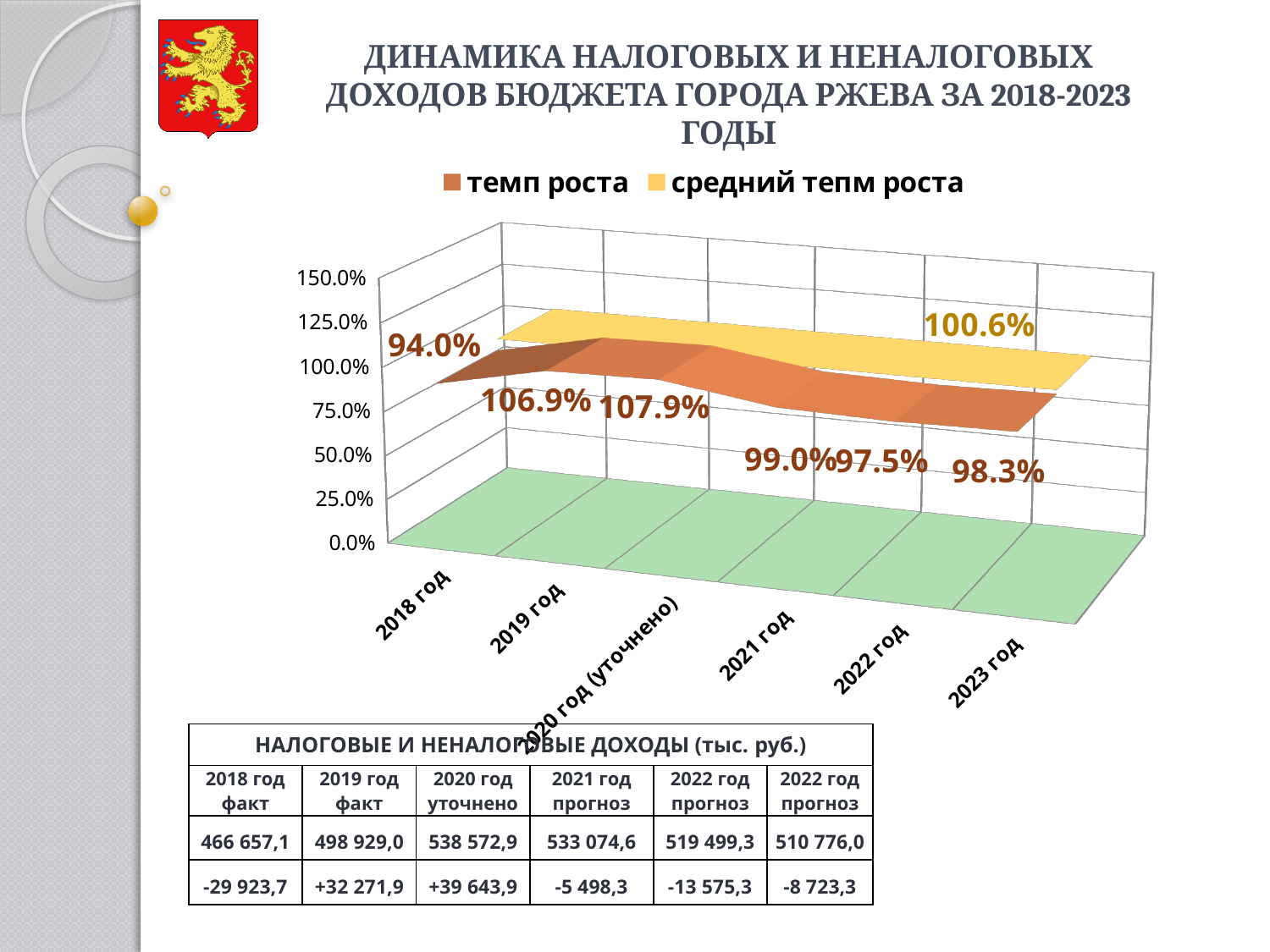
What is the value of темп роста for 2023 год? 98.3% In which year is темп роста lowest? 2018 год What is the value of темп роста for 2018 год? 94.0% What is the difference between темп роста in 2020 год (уточнено) and 2019 год? 1.0% How many series does the chart legend list? 2 What value is labelled for the средний тепм роста series? 100.6% Which is larger, темп роста for 2021 год or for 2022 год? 2021 год In which year is темп роста highest? 2020 год (уточнено) What is the value of темп роста for 2020 год (уточнено)? 107.9% How many years are shown on the x axis of the chart? 6 Does темп роста rise or fall from 2020 год (уточнено) to 2021 год? fall What kind of chart is shown on the slide? 3D line chart